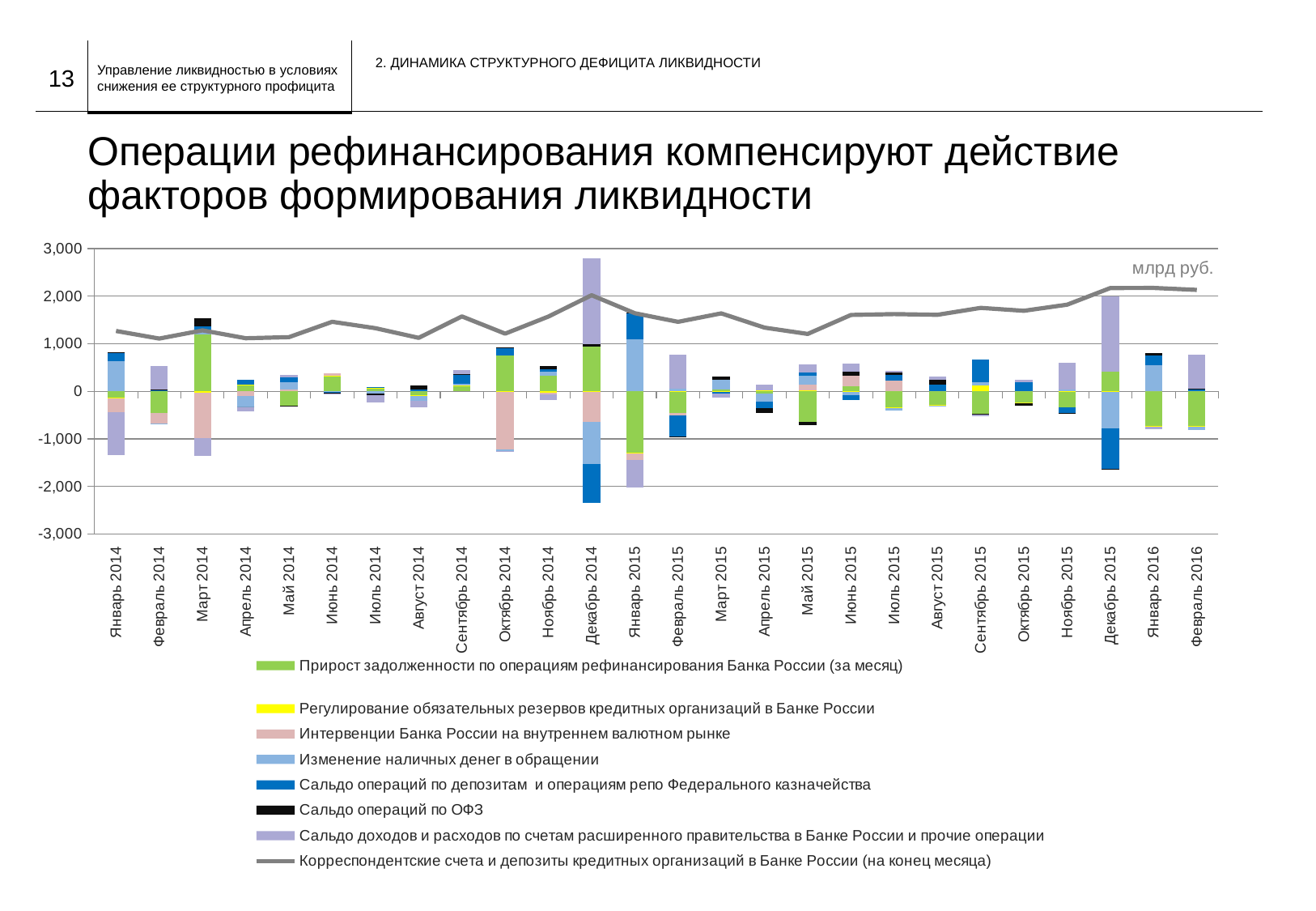
Which has the larger value on the grey line: Январь 2014 or Декабрь 2015? Декабрь 2015 Is the value of the grey line for Февраль 2015 greater or less than 2,000? less Is the top of the stacked bar for Декабрь 2014 greater or less than 2,000? greater Is the value of the grey line for Декабрь 2015 greater or less than 2,000? greater What kind of chart is shown on the slide? Stacked bar chart with a line How many series does the legend list? 8 How many months (categories) are shown along the x axis? 26 Which series is drawn as a grey line rather than bars? Корреспондентские счета и депозиты кредитных организаций в Банке России (на конец месяца) What unit is indicated in the top-right corner of the chart? млрд руб. Does the grey line overall rise or fall from Январь 2014 to Февраль 2016? rise